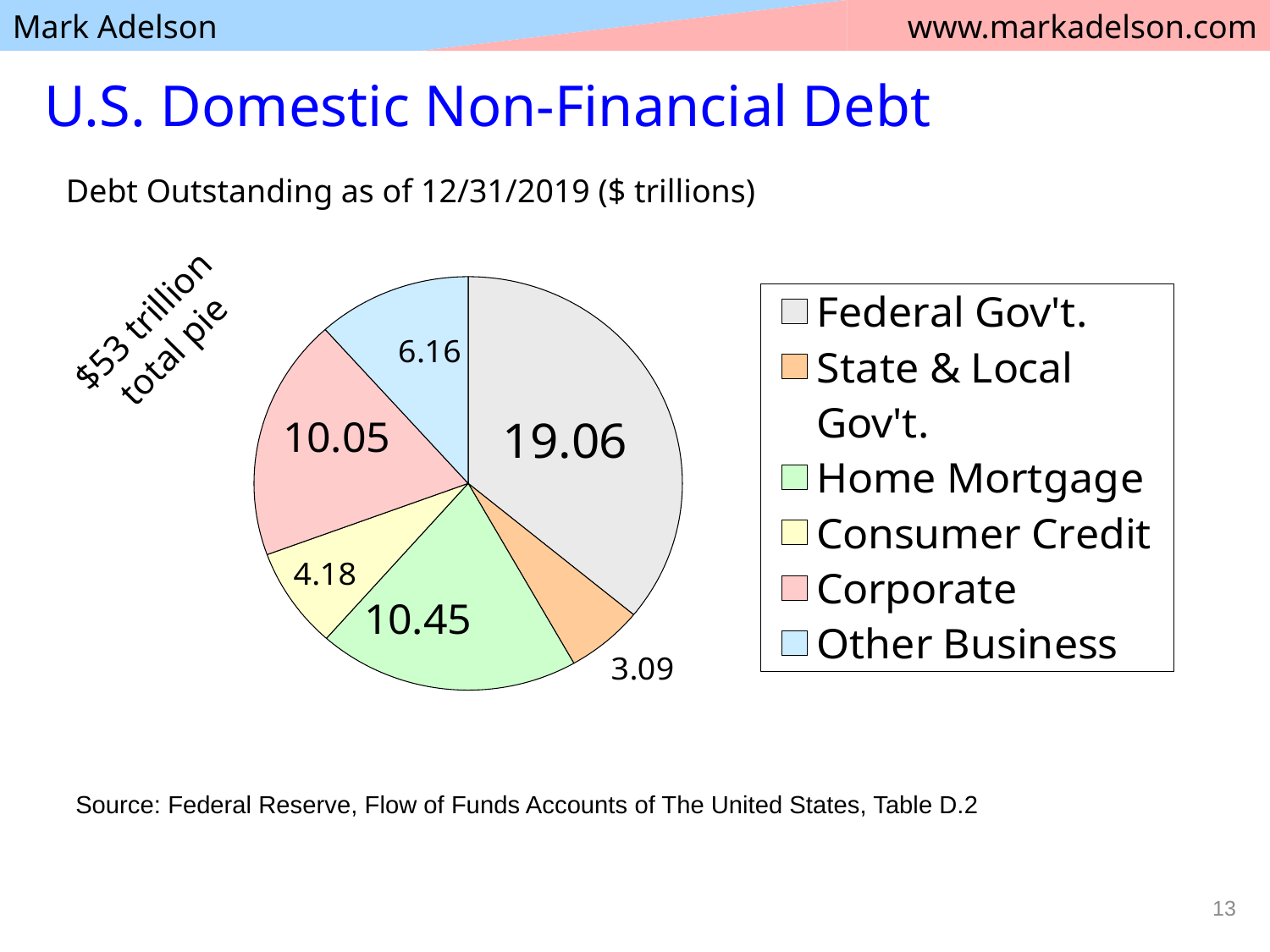
What is the value for Home Mortgage in the pie chart? 10.45 What is the value for State & Local Gov't. in the pie chart? 3.09 What is the difference between the Other Business value and the Consumer Credit value? 1.98 What is the value for Federal Gov't. in the pie chart? 19.06 What total does the slide give for the whole pie? $53 trillion Which is larger, Home Mortgage or Corporate? Home Mortgage Which category has the smallest slice of the pie chart? State & Local Gov't. What is the difference between the Federal Gov't. value and the State & Local Gov't. value? 15.97 How many categories does the pie chart show? 6 What is the value for Other Business in the pie chart? 6.16 What kind of chart is shown on the slide? Pie chart Which category has the largest slice of the pie chart? Federal Gov't.